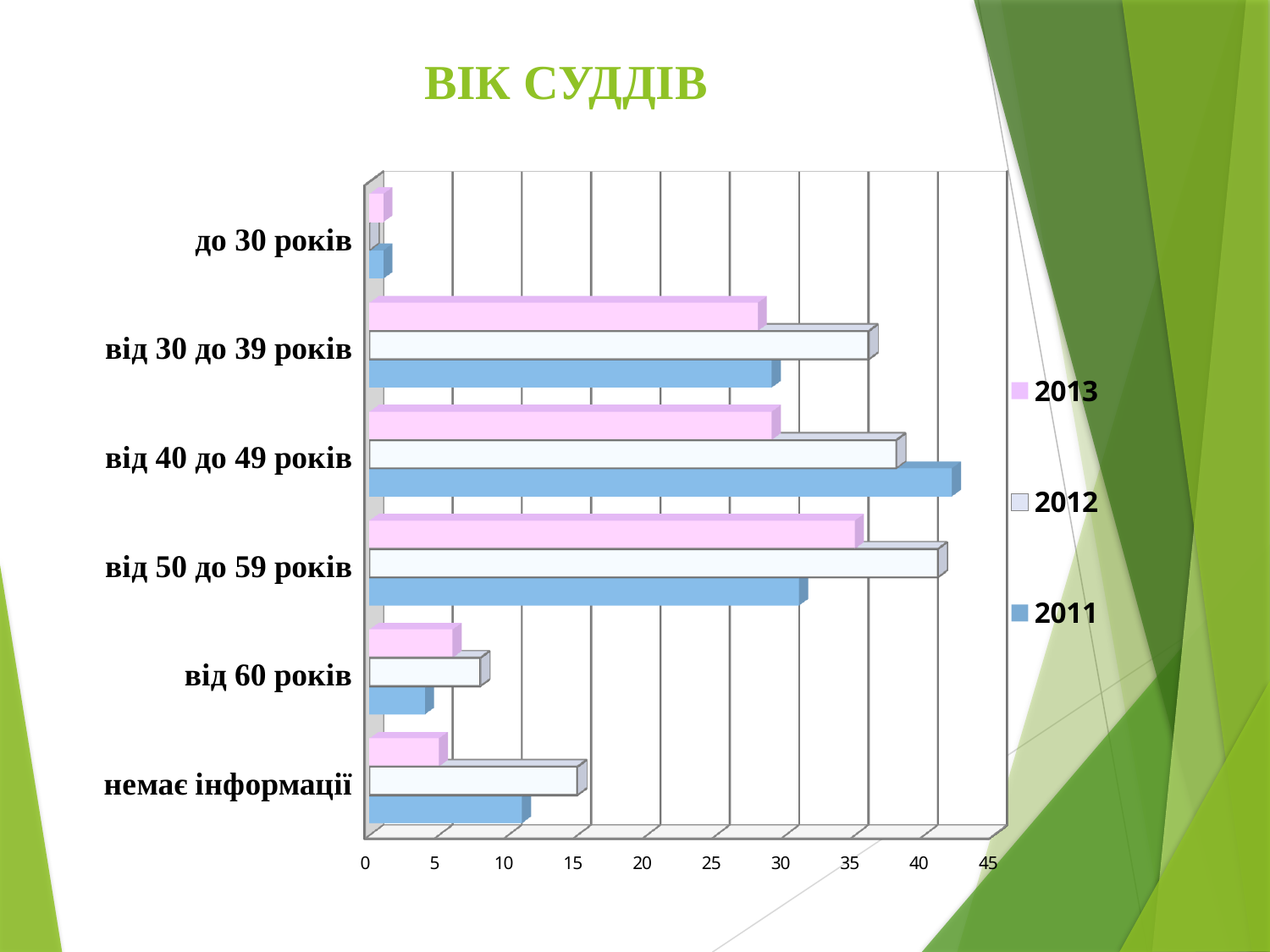
For 'від 40 до 49 років', which series has the larger value, 2011 or 2013? 2011 Which series is shown in blue in the legend? 2011 For 'від 50 до 59 років', which series has the larger value, 2012 or 2011? 2012 What is the title of the chart? ВІК СУДДІВ How many series does the legend list? 3 Is the 2012 value for 'немає інформації' greater or less than 10? greater How many age categories are shown on the chart? 6 Is the 2011 value for 'від 40 до 49 років' greater or less than 40? greater Is the 2012 value for 'від 60 років' greater or less than 10? less What kind of chart is shown on the slide? bar chart Which category has the highest 2011 value? від 40 до 49 років